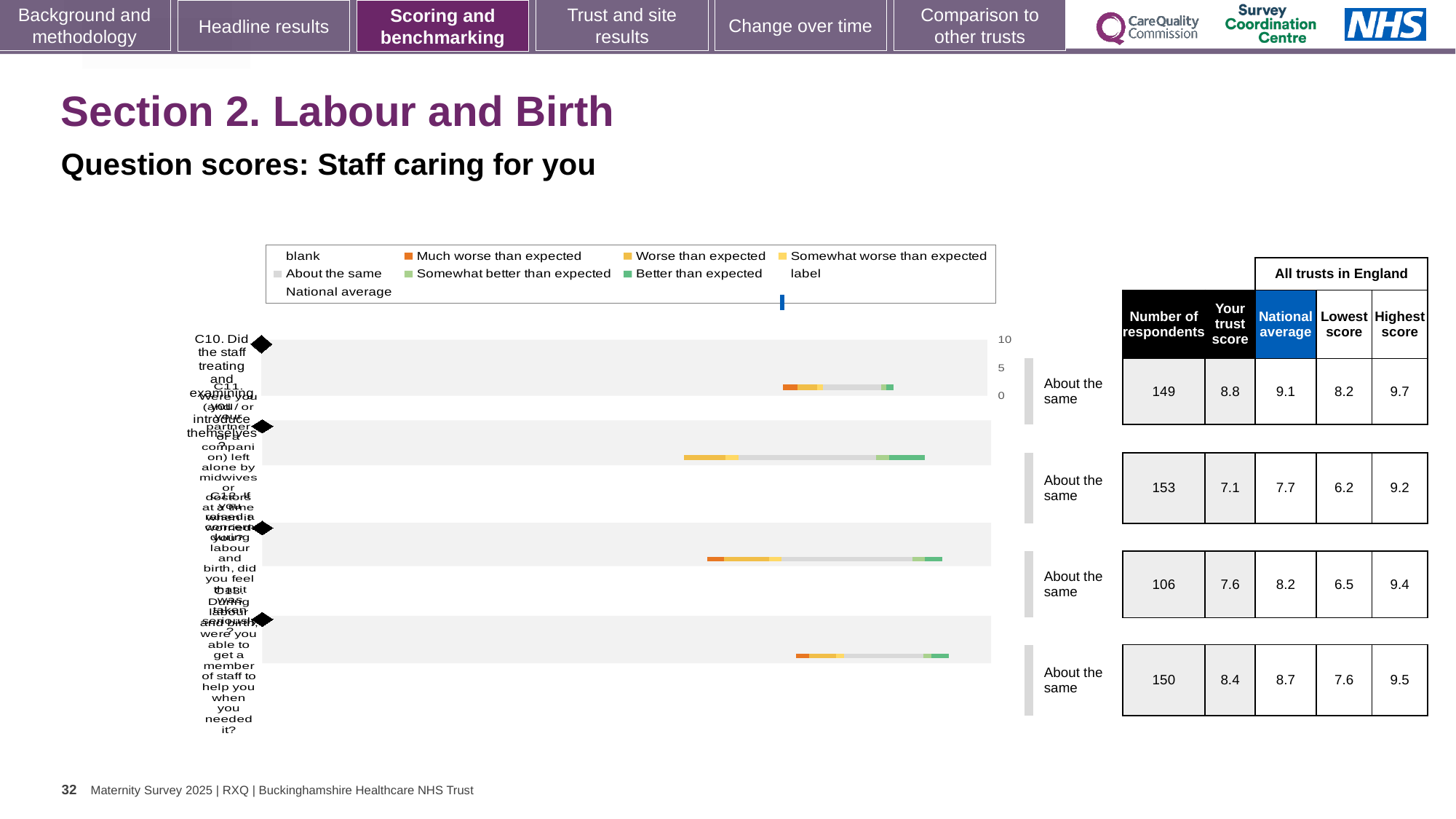
What is the heading above the National average, Lowest score and Highest score columns? All trusts in England Which row in the table has the lowest 'Your trust score'? the second row (7.1) In the table, what is the national average for the third row? 8.2 Which row in the table has the highest 'Your trust score'? the first row (8.8) What benchmark category is shown for all four rows? About the same What kind of chart is shown on the slide? bar chart What is the difference between the national average and the trust score in the second row of the table? 0.6 How many question rows are plotted in the chart? 4 In the table, what is the highest score for the fourth row? 9.5 In the table, what is the trust score for the second row? 7.1 Is the trust score in the first row of the table larger or smaller than the national average in that row? smaller In the table, what is the number of respondents for the first row? 149